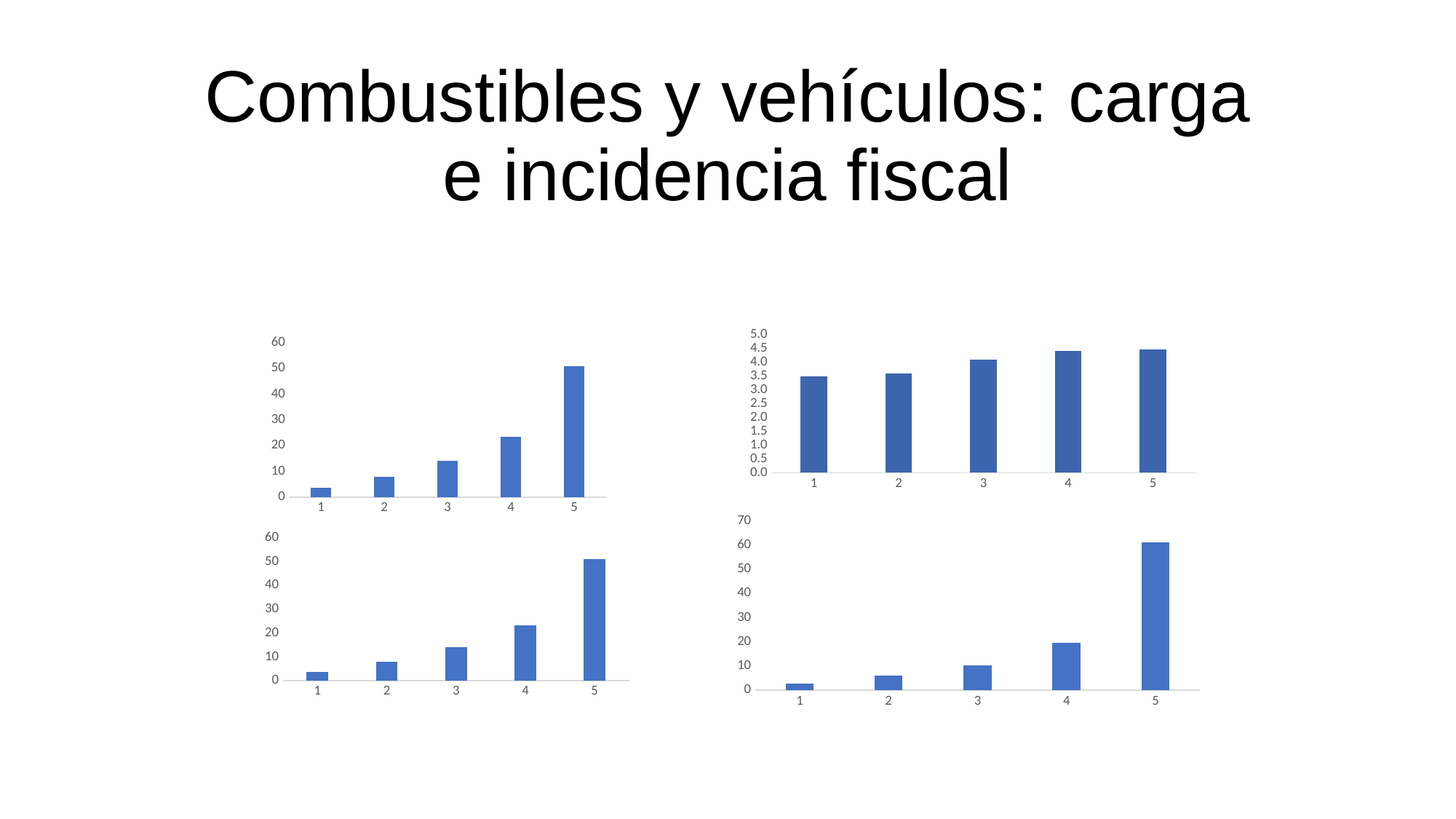
In the bottom-left chart, is the value for category 4 greater or less than 30? less In the bottom-right chart, is the value for category 5 greater or less than 50? greater In the top-left chart, which category has the highest bar? 5 In the top-right chart, which is larger, the value for category 1 or the value for category 3? category 3 How many charts are shown on the slide? 4 In the top-left chart, which category has the lowest bar? 1 In the bottom-right chart, which category has the highest bar? 5 What kind of chart is the top-left chart? bar chart How many categories does the top-left chart show on its x axis? 5 In the top-left chart, is the value for category 5 greater or less than 40? greater In the top-right chart, do the values rise or fall from category 1 to category 5? rise